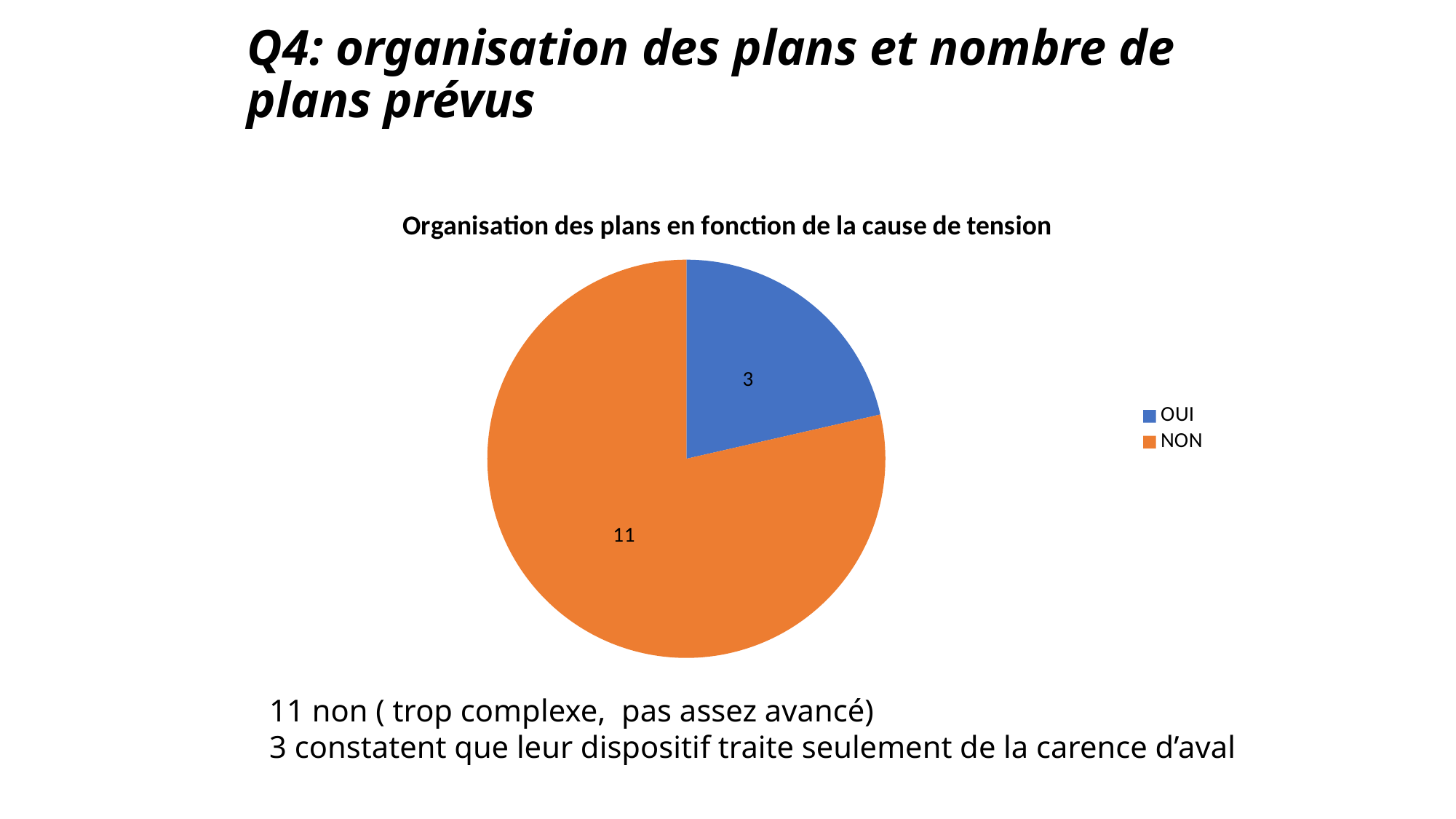
What kind of chart is shown? pie chart What is the value for OUI? 3 Which category has the largest slice? NON Which category has the smallest slice? OUI What is the title of the chart? Organisation des plans en fonction de la cause de tension What colour is the NON slice? orange How many entries does the legend list? 2 Which is larger, OUI or NON? NON What is the total of all slices in the pie chart? 14 What is the value for NON? 11 What is the difference between the NON and OUI values? 8 How many slices does the pie chart have? 2